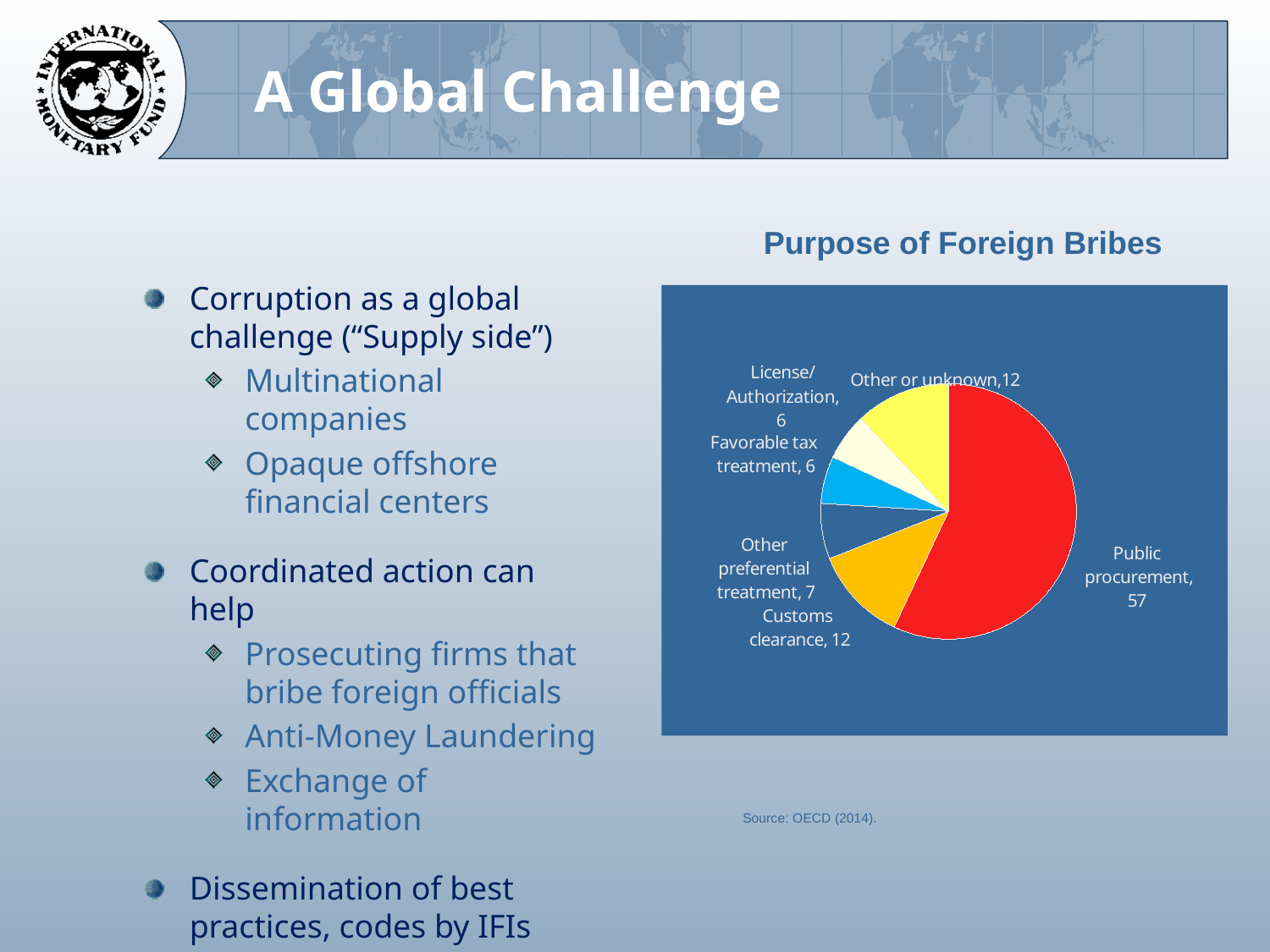
What is the total of all slice values in the Purpose of Foreign Bribes chart? 100 What is the value for Customs clearance in the Purpose of Foreign Bribes chart? 12 What is the value for Favorable tax treatment in the Purpose of Foreign Bribes chart? 6 What share of the Purpose of Foreign Bribes pie does Public procurement represent? 57% Which is larger in the Purpose of Foreign Bribes chart, Other preferential treatment or Favorable tax treatment? Other preferential treatment What is the value for Public procurement in the Purpose of Foreign Bribes chart? 57 What is the value for Other preferential treatment in the Purpose of Foreign Bribes chart? 7 What type of chart is shown under the title "Purpose of Foreign Bribes"? Pie chart What is the difference between the values for Public procurement and Customs clearance in the Purpose of Foreign Bribes chart? 45 How many slices does the Purpose of Foreign Bribes pie chart have? 6 What source is cited below the Purpose of Foreign Bribes chart? OECD (2014) Which category has the largest slice in the Purpose of Foreign Bribes chart? Public procurement